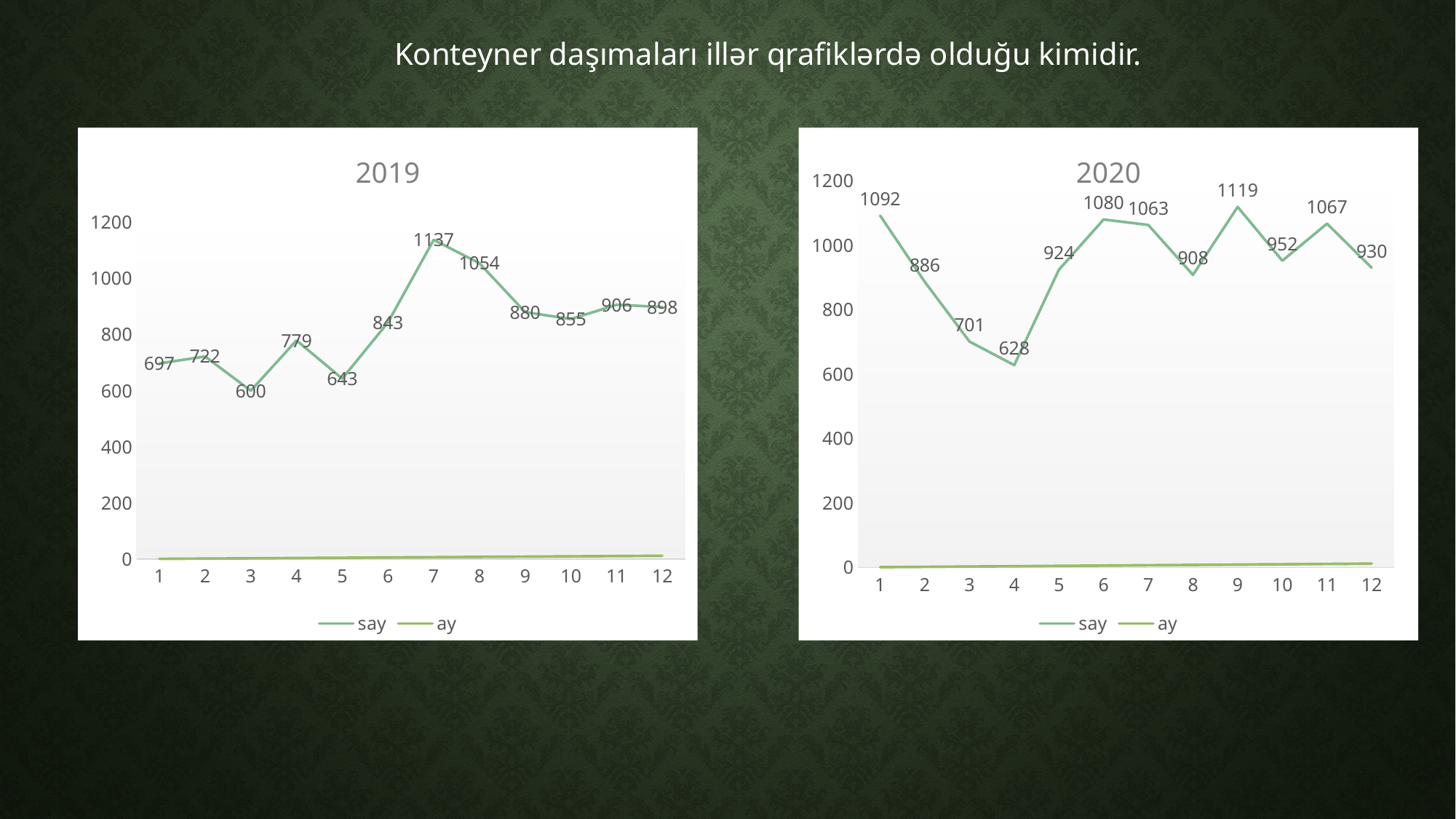
In the 2020 chart, does the 'say' series rise or fall from point 1 to point 4? fall In the 2019 chart, what is the value of the 'say' series at point 7? 1137 In the 2020 chart, at which x-axis point is the 'say' series highest? 9 In the 2020 chart, what is the value of the 'say' series at point 4? 628 In the 2020 chart, which is larger: the 'say' value at point 6 or at point 7? point 6 How many series does the legend of the 2020 chart list? 2 In the 2019 chart, what is the difference between the 'say' values at points 7 and 8? 83 In the 2019 chart, at which x-axis point is the 'say' series lowest? 3 In the 2019 chart, is the 'say' value at point 9 greater or less than 800? greater What type of chart is the 2020 chart? line chart How many x-axis points does the 2019 chart have? 12 In the 2020 chart, what is the difference between the 'say' values at points 1 and 2? 206